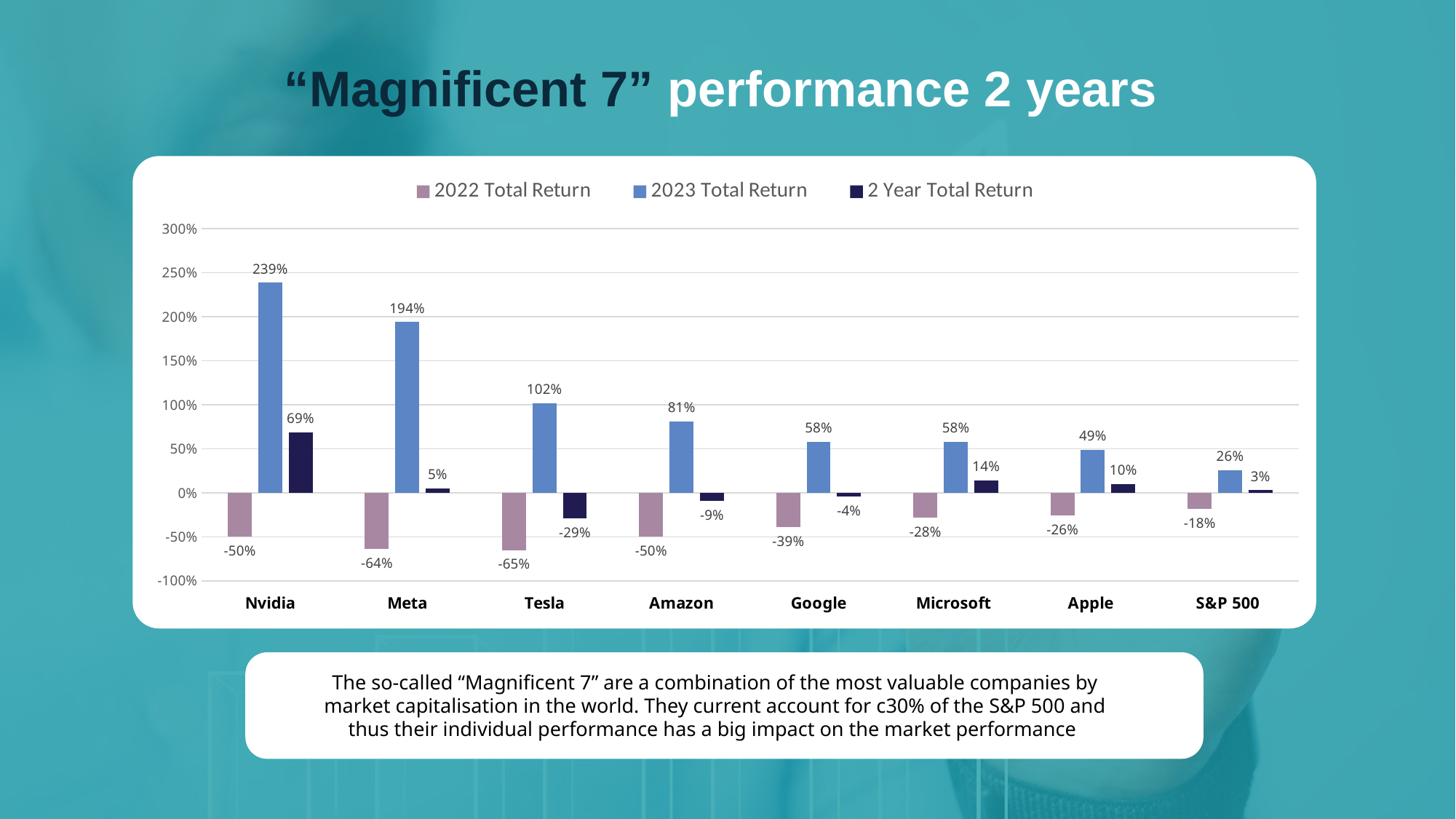
Is the 2023 Total Return for Tesla greater or less than 50%? greater What is the 2023 Total Return for Nvidia? 239% What is the title of the slide? "Magnificent 7" performance 2 years How many series does the legend list? 3 What kind of chart is shown on the slide? Bar chart Which is larger, the 2023 Total Return for Amazon or for Apple? Amazon Which category has the lowest 2 Year Total Return? Tesla What is the 2 Year Total Return for Microsoft? 14% What is the difference between the 2023 Total Return for Nvidia and Meta? 45% How many categories are shown on the x axis? 8 What is the 2022 Total Return for Tesla? -65% Which category has the highest 2023 Total Return? Nvidia